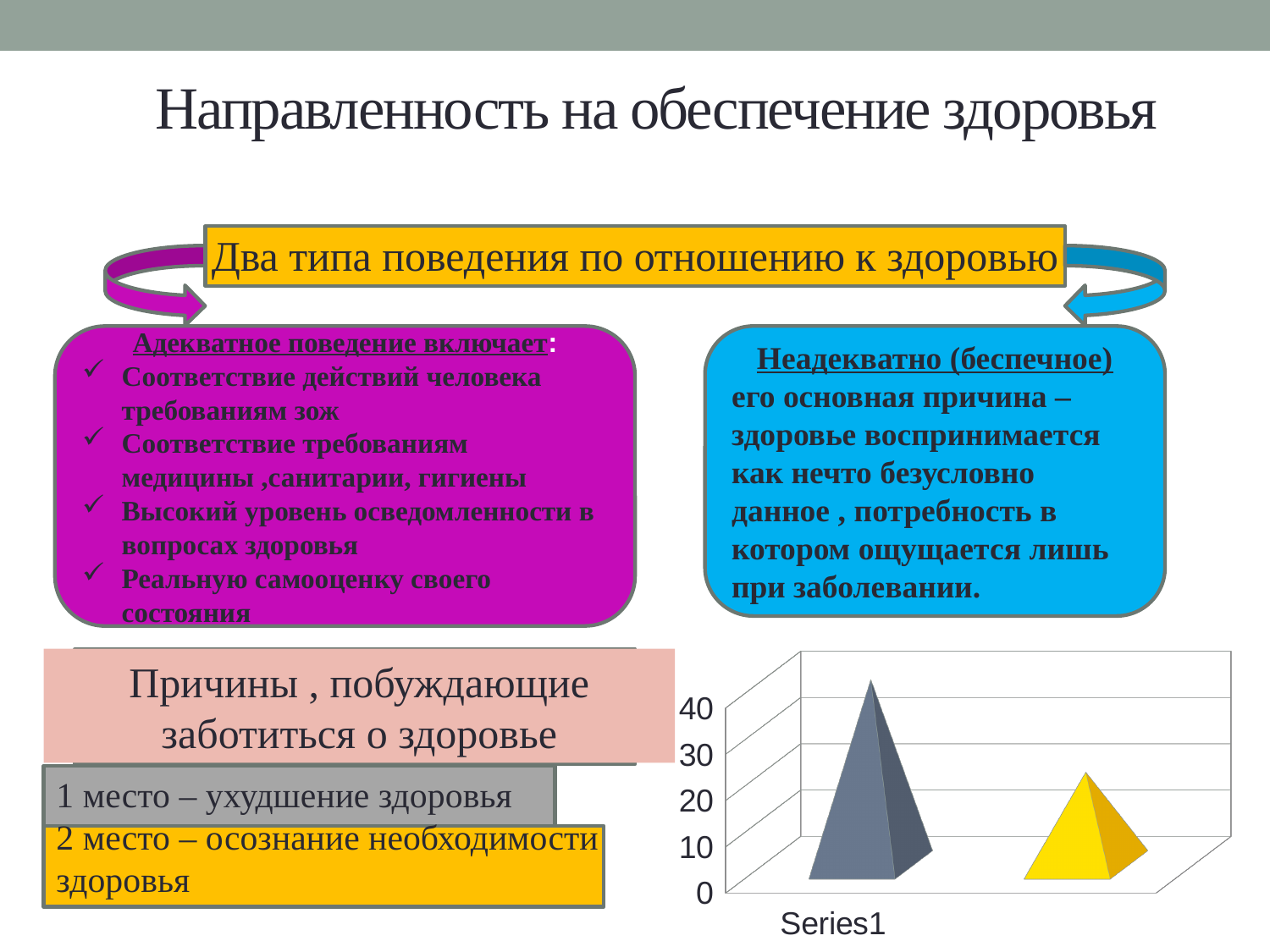
What kind of chart is shown at the bottom right of the slide? bar chart In the chart at the bottom right, which bar is taller, the left (blue-grey) one or the right (yellow) one? the left (blue-grey) one What label appears below the horizontal axis of the chart at the bottom right? Series1 What is the highest value shown on the vertical axis of the chart at the bottom right? 40 In the chart at the bottom right, is the value of the right (yellow) bar greater or less than 30? less In the chart at the bottom right, is the value of the left (blue-grey) bar greater or less than 30? greater In the chart at the bottom right, is the value of the right (yellow) bar greater or less than 10? greater How many bars (pyramids) are plotted in the chart at the bottom right of the slide? 2 In the chart at the bottom right, which bar has the lowest value? the right (yellow) one